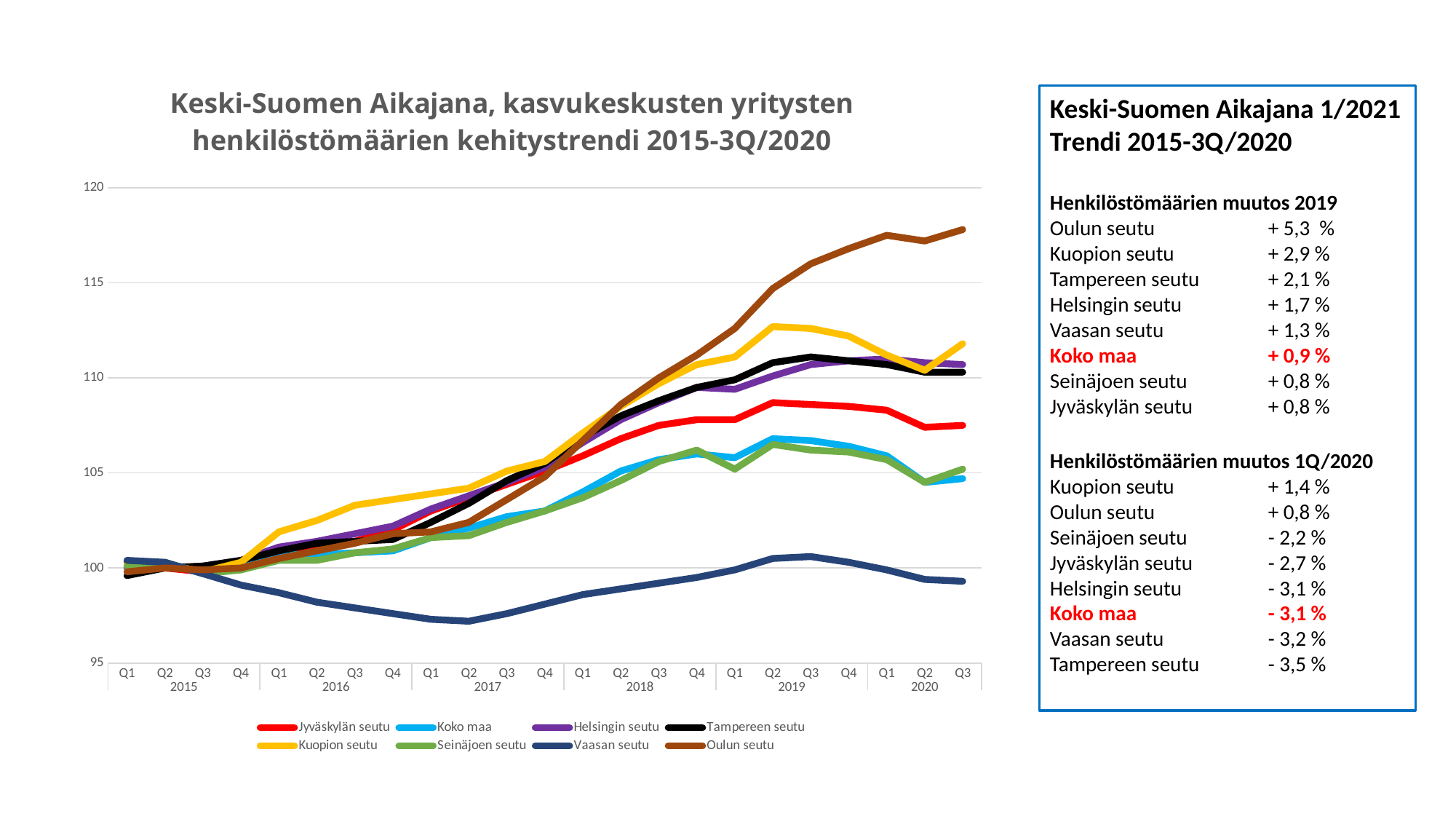
At Q3 2020, which is higher: Oulun seutu or Kuopion seutu? Oulun seutu Does the Oulun seutu line generally rise or fall from Q1 2015 to Q3 2020? Rise What colour is the Oulun seutu line in the legend? Brown What kind of chart is shown on the slide? Line chart How many quarterly points are plotted along the x axis, from Q1 2015 to Q3 2020? 23 Is the value for Kuopion seutu at Q2 2019 greater or less than 110? greater At Q3 2020, which is higher: Koko maa or Vaasan seutu? Koko maa How many series does the chart legend list? 8 Which series has the highest value at Q3 2020? Oulun seutu Is the value for Oulun seutu at Q3 2020 greater or less than 115? greater Is the value for Vaasan seutu at Q2 2017 greater or less than 100? less Which series has the lowest value at Q3 2020? Vaasan seutu